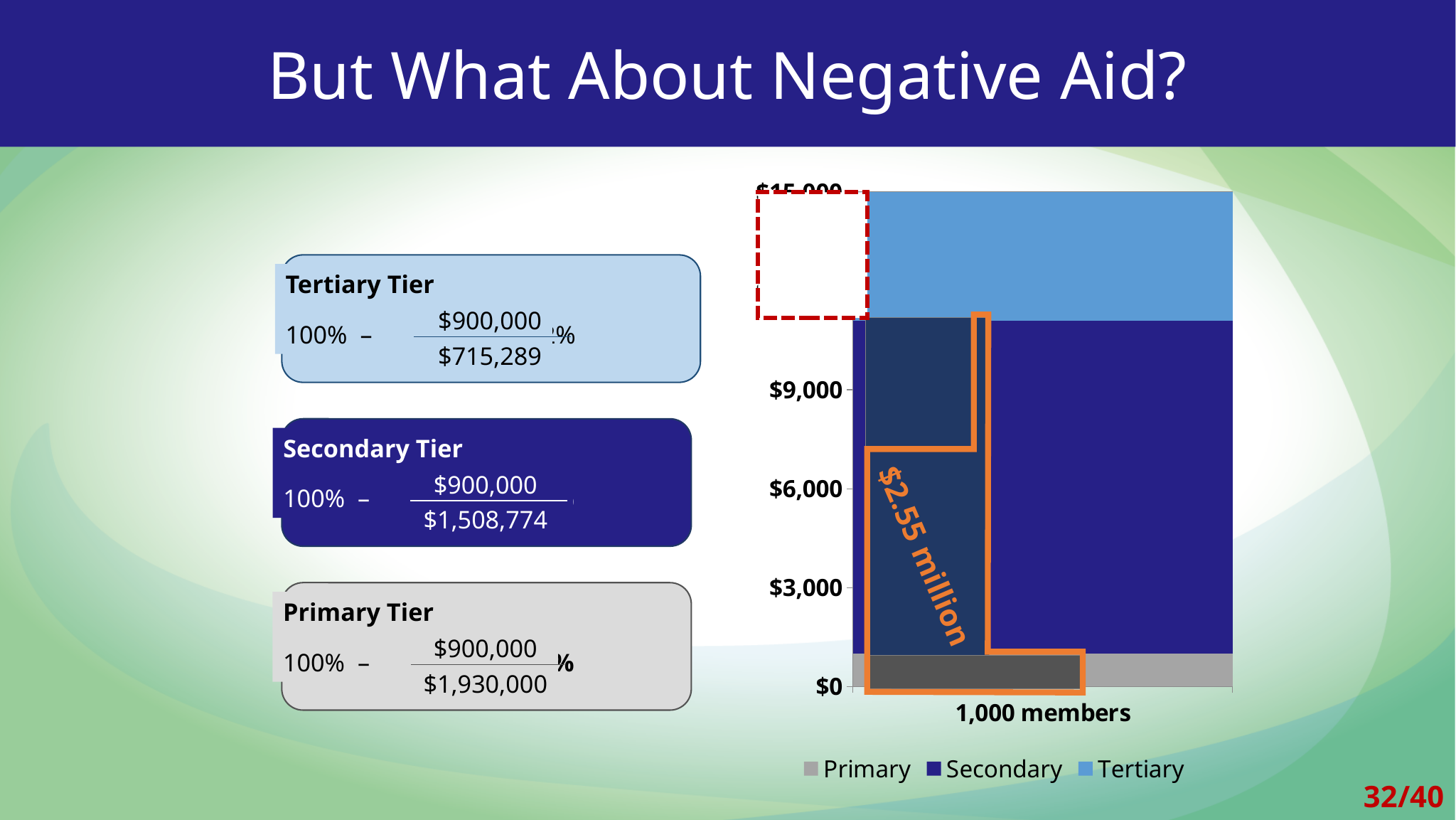
What are the series names listed in the chart legend? Primary, Secondary, Tertiary Is the total height of the stacked bar greater or less than $9,000? greater Which series has the smallest segment in the stacked bar? Primary Which segment is larger in the stacked bar, Secondary or Tertiary? Secondary How many bars (categories) are plotted on the x axis of the chart? 1 Is the Primary segment of the stacked bar greater or less than $3,000? less What kind of chart is shown on the slide? Stacked bar chart Is the top of the Secondary segment greater or less than $15,000? less What is the category label shown under the bar on the x axis? 1,000 members How many series does the chart legend list? 3 Which series has the largest segment in the stacked bar? Secondary